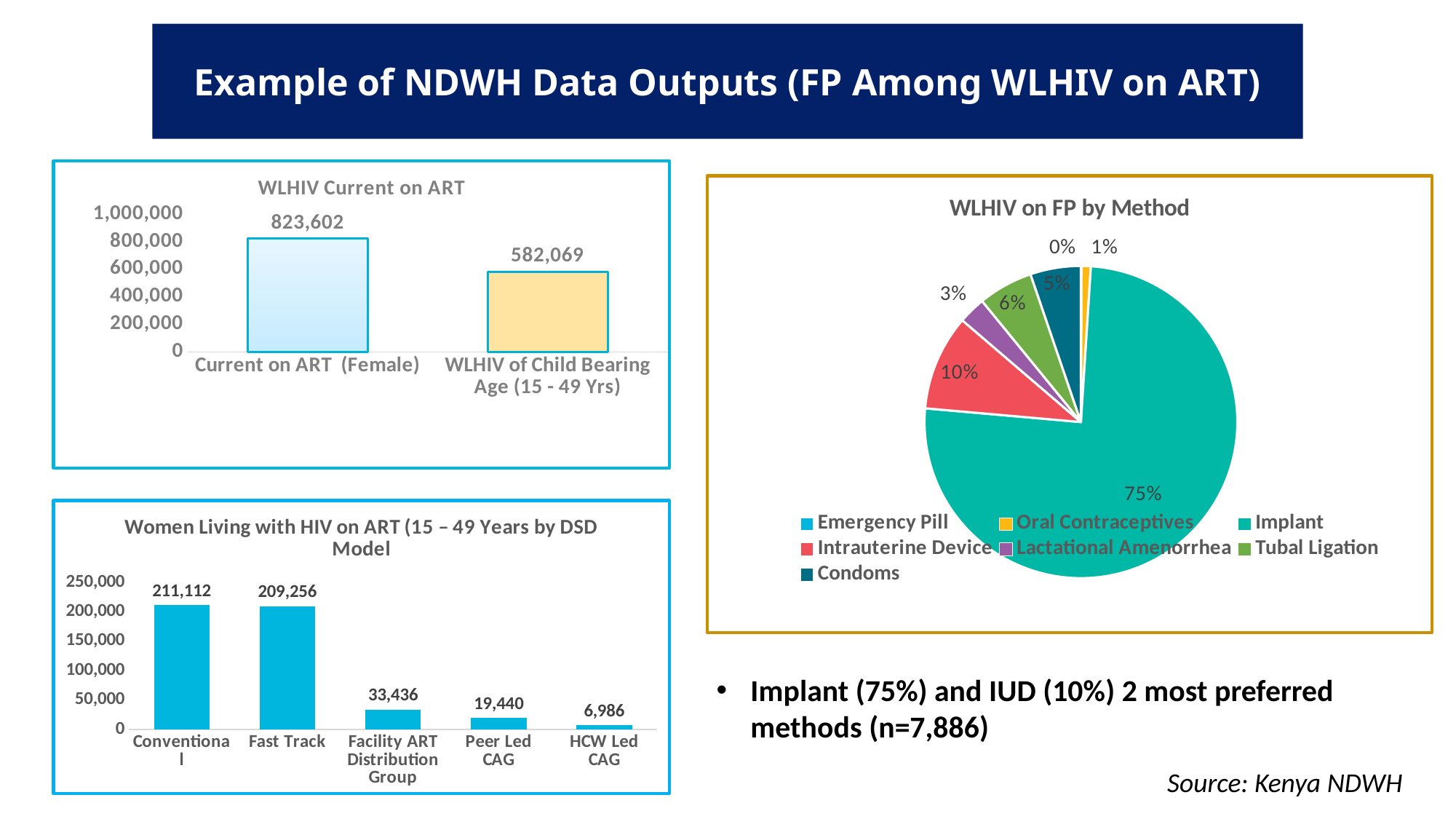
In the 'WLHIV on FP by Method' pie chart, which is larger, Condoms or Intrauterine Device? Intrauterine Device In the 'Women Living with HIV on ART (15 – 49 Years by DSD Model' chart, what kind of chart is used? Bar chart In the 'Women Living with HIV on ART (15 – 49 Years by DSD Model' chart, which DSD model has the lowest value? HCW Led CAG In the 'Women Living with HIV on ART (15 – 49 Years by DSD Model' chart, how many DSD model categories are shown? 5 In the 'Women Living with HIV on ART (15 – 49 Years by DSD Model' chart, what is the value for Fast Track? 209,256 In the 'WLHIV Current on ART' chart, what is the difference between Current on ART (Female) and WLHIV of Child Bearing Age (15 - 49 Yrs)? 241,533 In the 'WLHIV Current on ART' chart, what is the value for WLHIV of Child Bearing Age (15 - 49 Yrs)? 582,069 How many methods does the legend of the 'WLHIV on FP by Method' pie chart list? 7 In the 'Women Living with HIV on ART (15 – 49 Years by DSD Model' chart, what is the difference between Facility ART Distribution Group and Peer Led CAG? 13,996 In the 'WLHIV Current on ART' chart, what is the value for Current on ART (Female)? 823,602 In the 'WLHIV on FP by Method' pie chart, what share does Tubal Ligation have? 6% In the 'WLHIV on FP by Method' pie chart, what share does Implant have? 75%